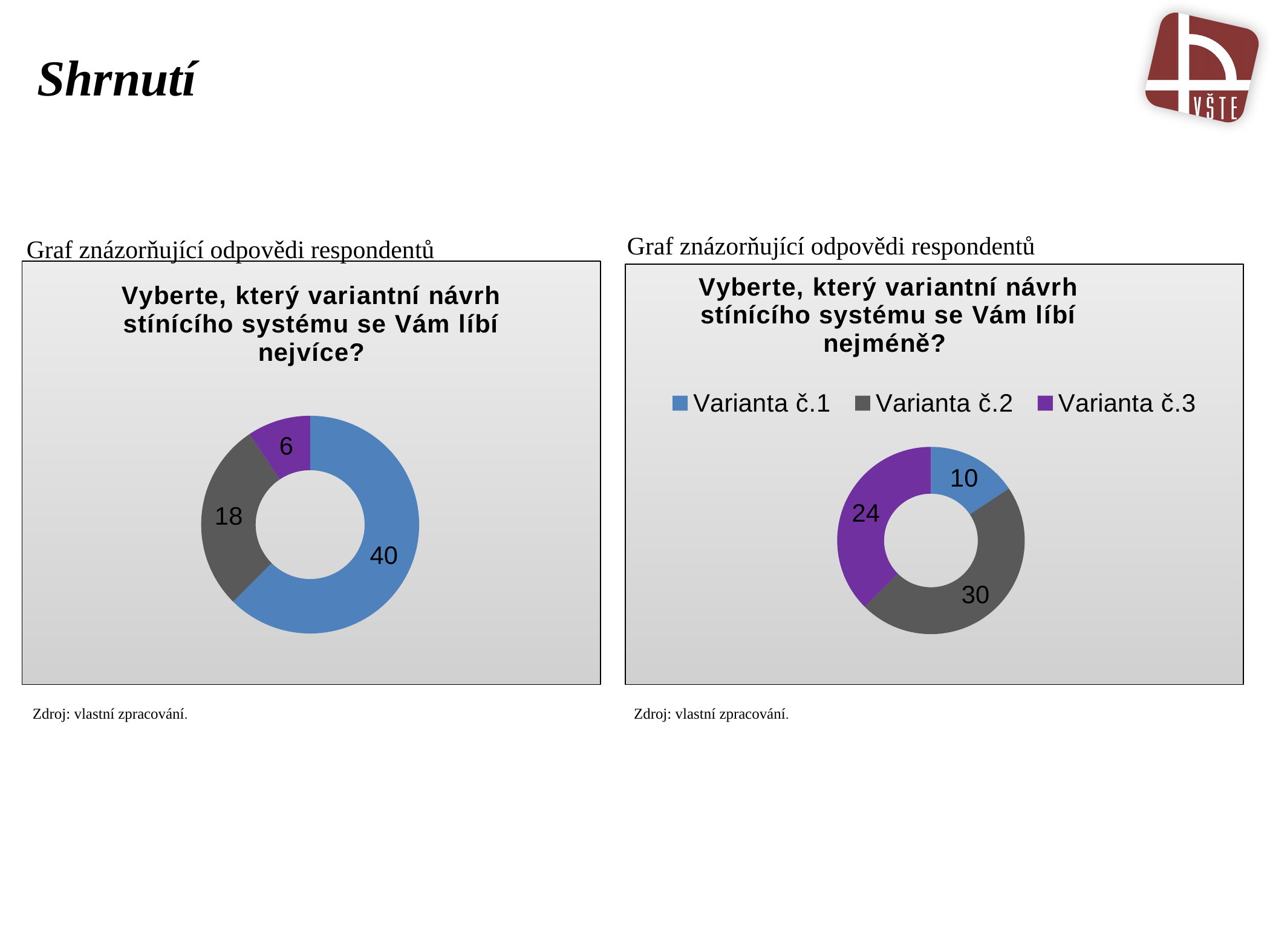
In the right chart ("...se Vám líbí nejméně?"), what is the value for Varianta č.2? 30 In the right chart ("...se Vám líbí nejméně?"), which is larger, the value for Varianta č.1 or Varianta č.3? Varianta č.3 In the right chart ("...se Vám líbí nejméně?"), what is the difference between the values for Varianta č.2 and Varianta č.3? 6 In the left chart ("...se Vám líbí nejvíce?"), what is the smallest value shown? 6 What type of chart is the left chart ("...se Vám líbí nejvíce?")? doughnut chart In the left chart ("...se Vám líbí nejvíce?"), what is the difference between the largest and smallest values? 34 How many entries does the legend of the right chart ("...se Vám líbí nejméně?") list? 3 In the right chart ("...se Vám líbí nejméně?"), which variant has the lowest value? Varianta č.1 In the right chart ("...se Vám líbí nejméně?"), what is the value for Varianta č.3? 24 In the left chart ("...se Vám líbí nejvíce?"), what value is shown on the blue slice? 40 In the right chart ("...se Vám líbí nejméně?"), which variant has the highest value? Varianta č.2 In the right chart ("...se Vám líbí nejméně?"), what is the value for Varianta č.1? 10